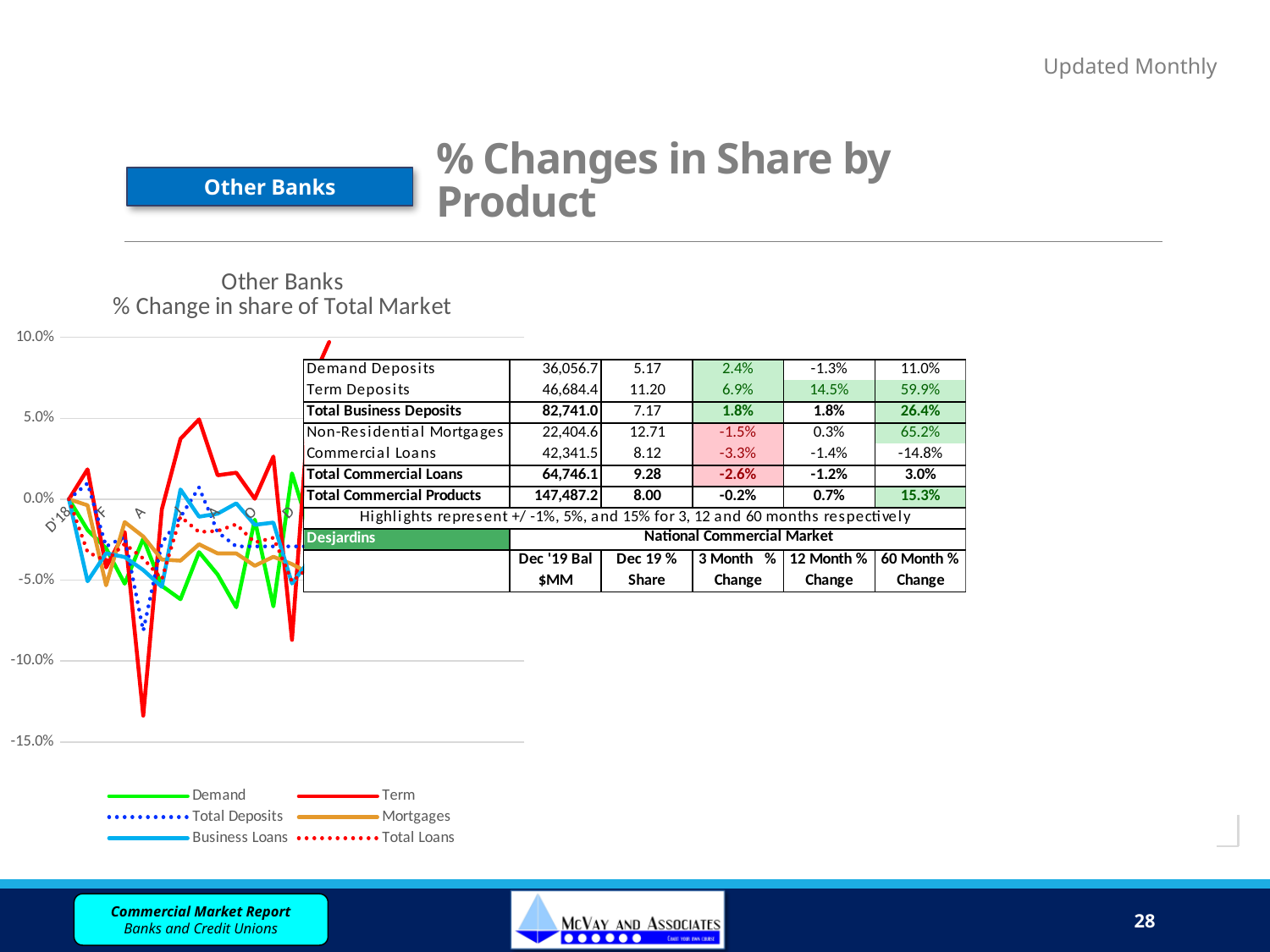
How many series does the chart legend list? 6 Is the lowest point of the Term line greater or less than -10.0%? less Which colour is used for the Term series in the chart? Red What is the lowest value shown on the chart's vertical axis? -15.0% What kind of chart is shown on the slide? Line chart Which two series are drawn with dotted lines in the chart? Total Deposits and Total Loans Which series reaches the lowest value on the chart? Term Is the lowest point of the Demand line greater or less than -10.0%? greater